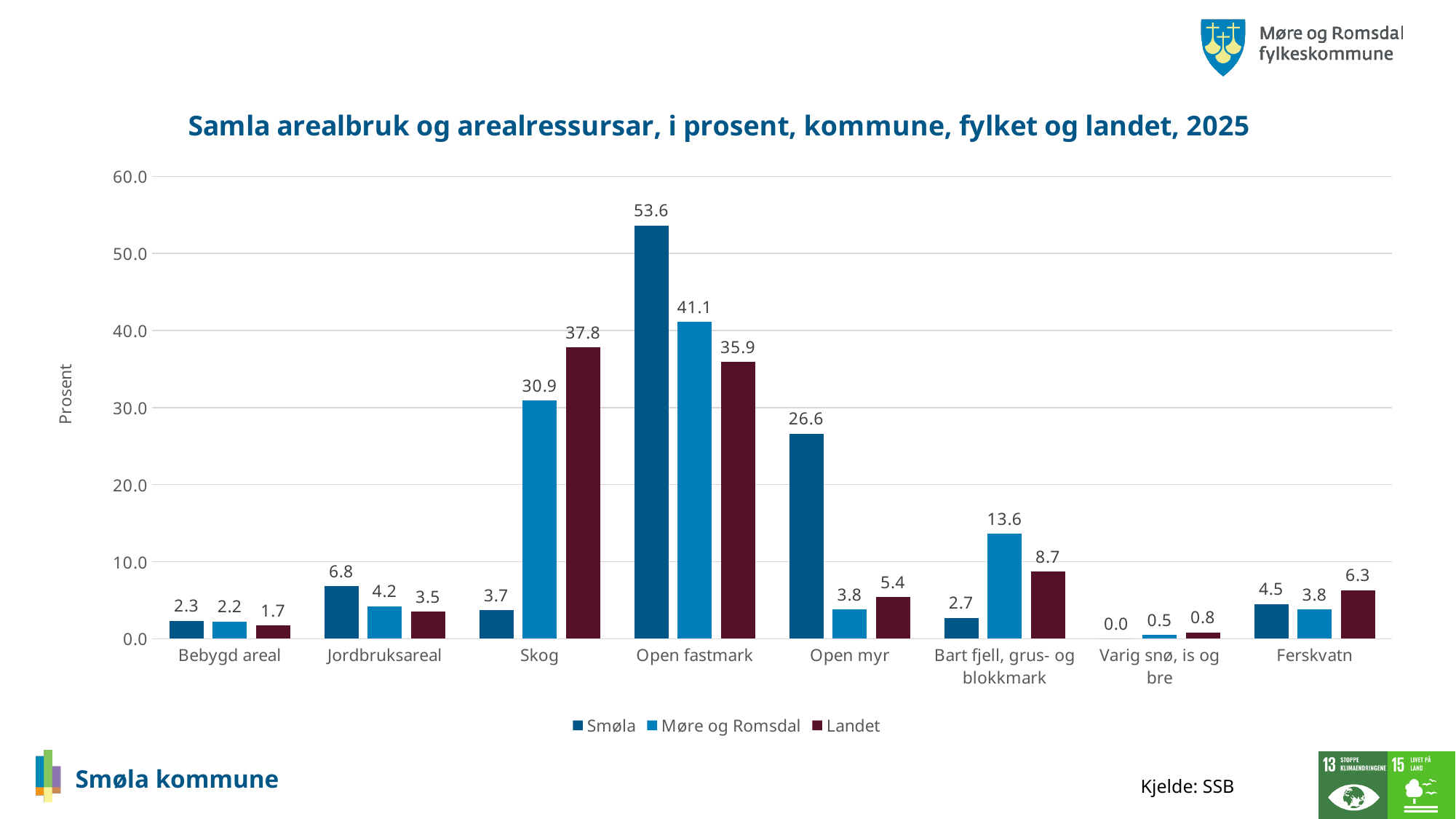
What is the value for Landet in the Skog category? 37.8 How many series does the legend list? 3 What is the label of the y axis? Prosent Which is larger in the Skog category: the value for Møre og Romsdal or the value for Landet? Landet What kind of chart is shown on the slide? Bar chart What is the value for Smøla in the Open fastmark category? 53.6 What is the value for Møre og Romsdal in the Bart fjell, grus- og blokkmark category? 13.6 How many categories are shown on the x axis? 8 Which category has the lowest value for Landet? Varig snø, is og bre Is the value for Møre og Romsdal in the Open fastmark category greater or less than 40.0? greater Which category has the highest value for Smøla? Open fastmark What is the difference between the Smøla and Landet values for Open myr? 21.2